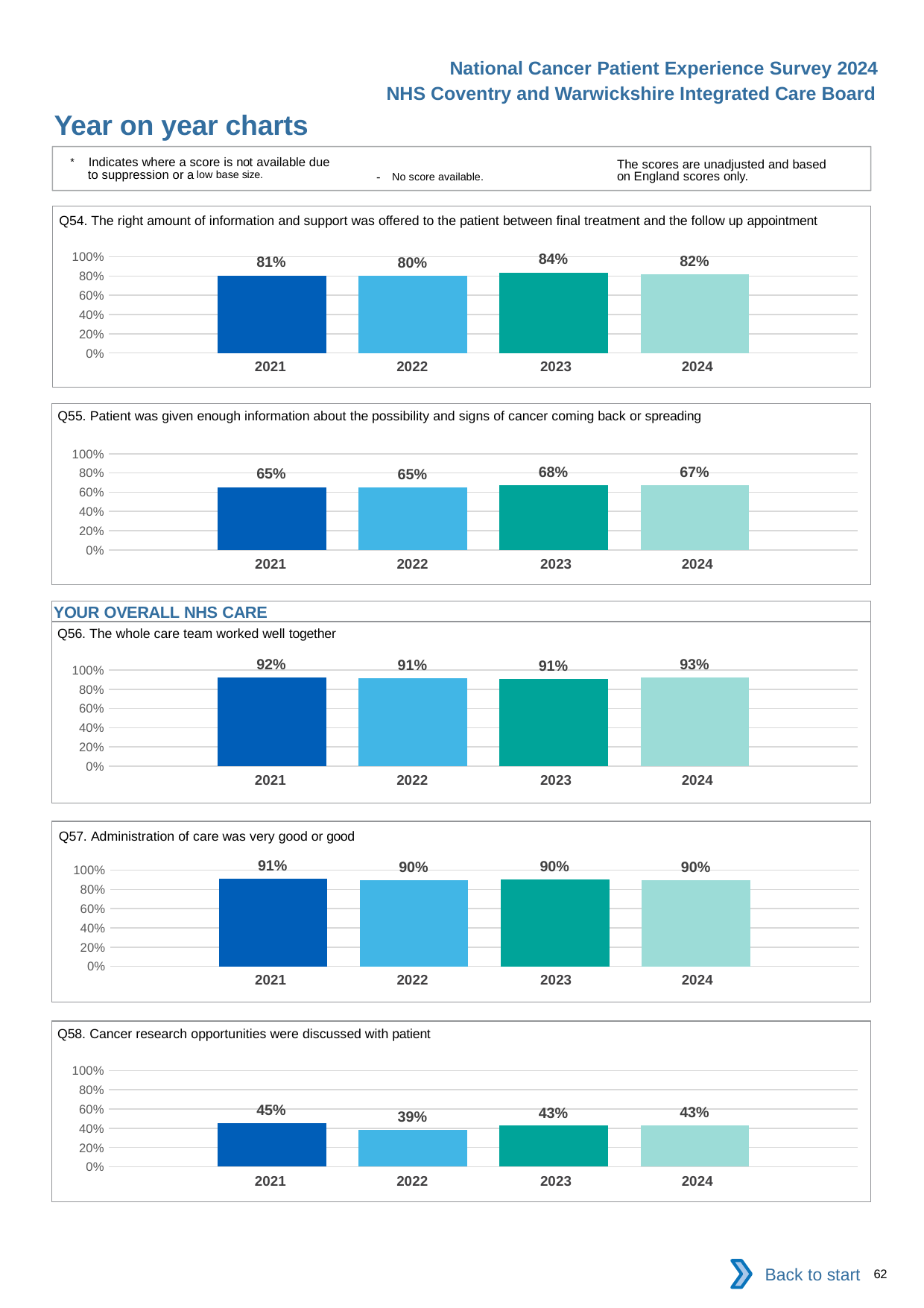
In the Q57 chart, what is the value for 2021? 91% In the Q55 chart, what is the value for 2024? 67% In the Q56 chart, which is larger, the value for 2021 or the value for 2024? 2024 In the Q54 chart, what is the value for 2023? 84% In the Q54 chart, what is the difference between the 2023 value and the 2022 value? 4% In the Q55 chart, which year has the highest value? 2023 In the Q58 chart, what is the difference between the 2021 value and the 2022 value? 6% How many charts are shown on the slide? 5 In the Q58 chart, is the value for 2021 greater or less than 60%? less How many years are shown in the Q55 chart? 4 What kind of chart is the Q56 chart? bar chart In the Q58 chart, which year has the lowest value? 2022